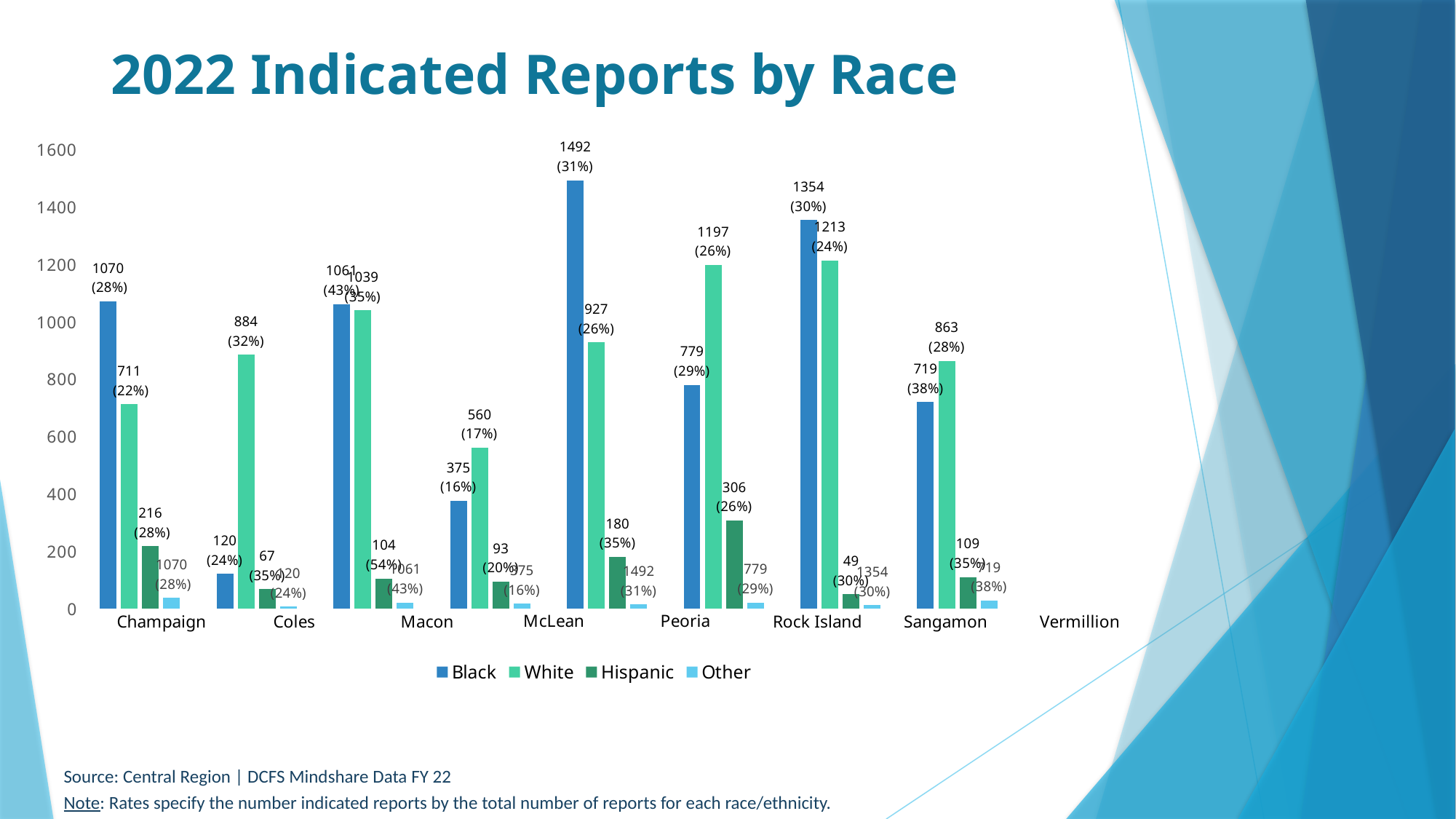
Which county has the highest value for Black? McLean In Peoria, which is larger, the Black value or the White value? White How many counties are listed along the x axis? 8 What is the number of indicated reports for White in Coles? 884 What kind of chart is shown on the slide? Bar chart What rate is shown in parentheses for Hispanic in Macon? 54% How many series does the legend list? 4 How many indicated reports are shown for Black in McLean? 1492 Is the value for White in Sangamon greater or less than 800? greater Which county has the lowest value for Hispanic? Rock Island What is the value for Hispanic in Peoria? 306 What is the difference between the Black and White values in Champaign? 359